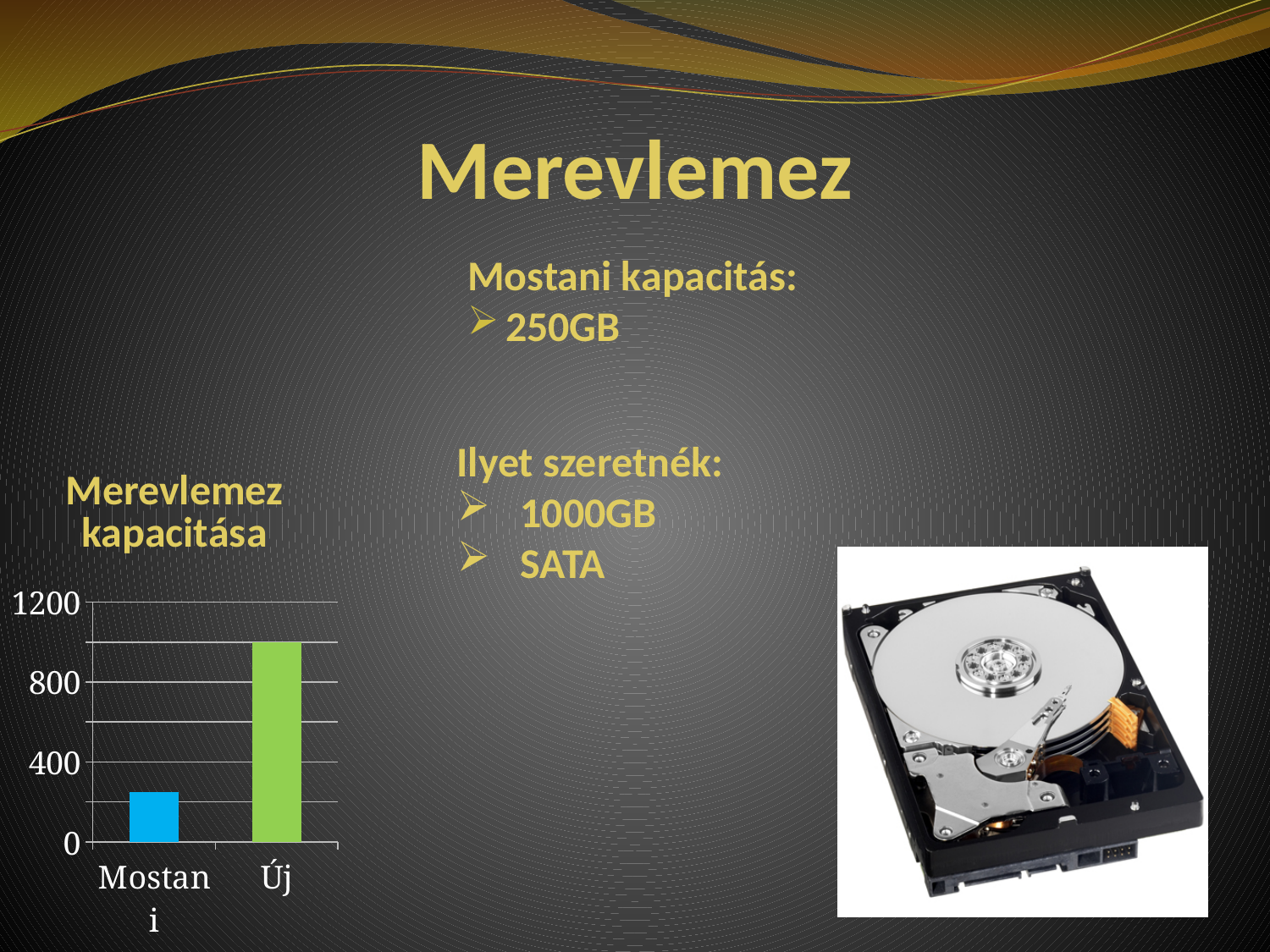
Which bar is taller, Mostani or Új? Új Which category has the highest bar in the chart? Új Which category has the lowest bar in the chart? Mostani How many categories are shown on the chart's x axis? 2 What is the highest value shown on the chart's vertical axis? 1200 Is the value for Új greater or less than 800? greater What is the title of the chart on the slide? Merevlemez kapacitása Is the value for Új greater or less than 1200? less What kind of chart is shown on the slide? bar chart Do the bar values rise or fall from Mostani to Új? rise Is the value for Mostani greater or less than 400? less